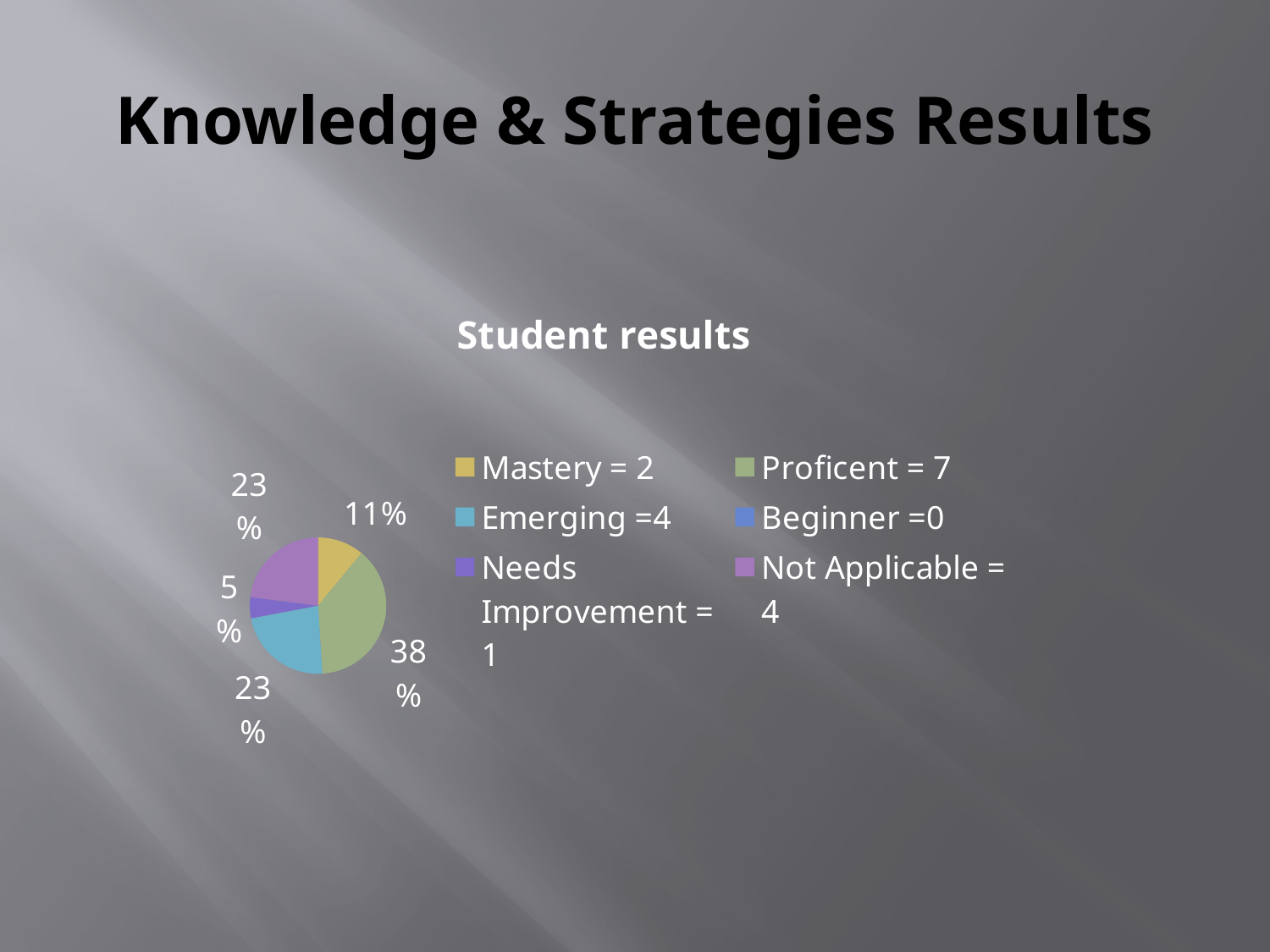
What kind of chart is shown on the slide? pie chart How many categories does the chart's legend list? 6 Which slice is larger, Proficent or Emerging? Proficent What share of the pie does the Mastery slice represent? 11% What is the difference in percentage points between the Proficent slice and the Mastery slice? 27% What is the title of the chart? Student results What share of the pie does the Emerging slice represent? 23% Which of the labeled slices is the smallest? Needs Improvement Which category has the largest slice of the pie? Proficent What share of the pie does the Proficent slice represent? 38% According to the legend, how many students are in the Proficent category? 7